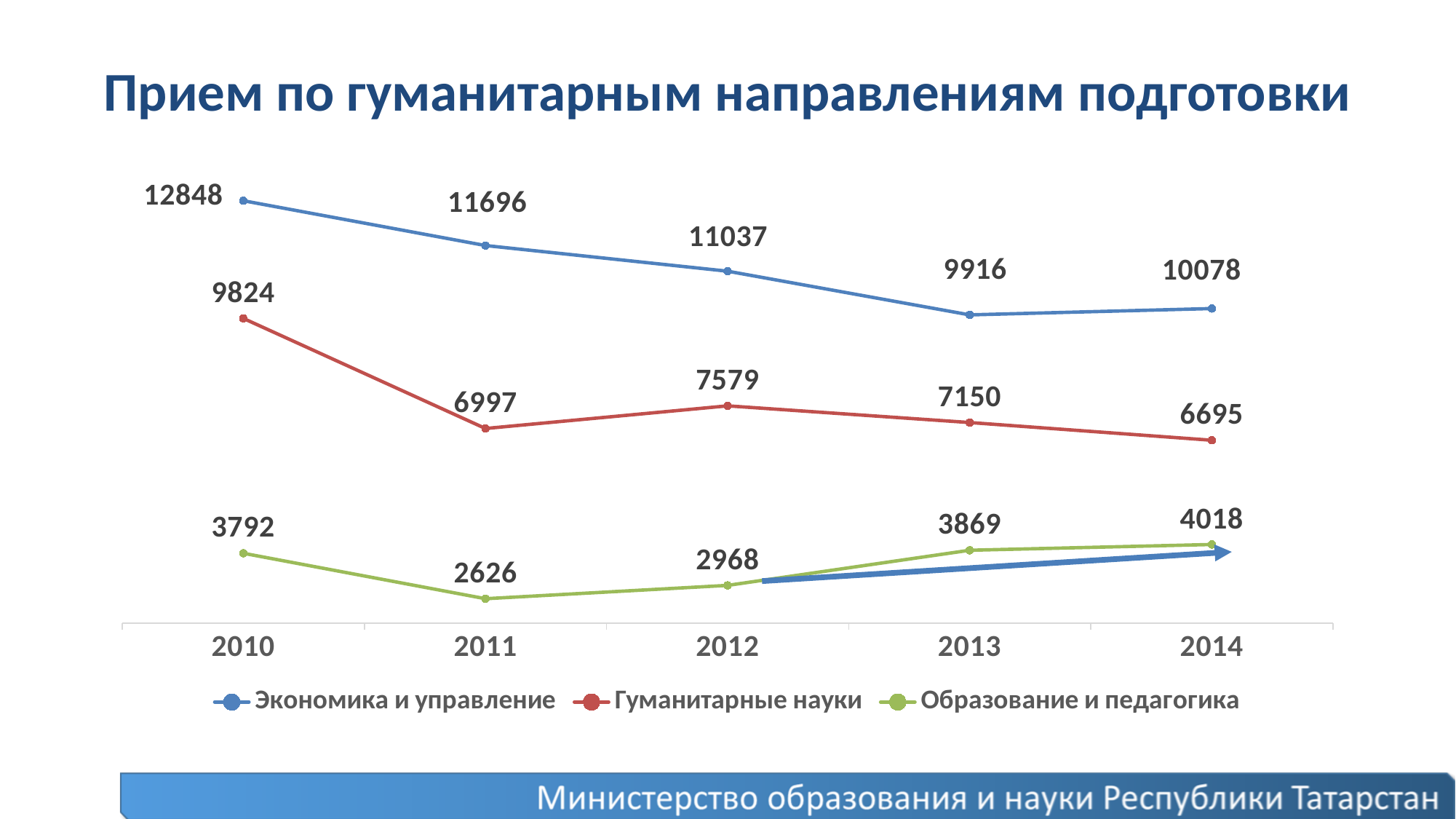
What is the difference between the Гуманитарные науки values in 2010 and 2011? 2827 What kind of chart is shown on the slide? line chart In which year is the value for Экономика и управление highest? 2010 In which year is the value for Образование и педагогика lowest? 2011 What is the difference between the Экономика и управление values in 2010 and 2014? 2770 What is the value for Экономика и управление in 2010? 12848 How many series does the legend list? 3 What is the value for Образование и педагогика in 2014? 4018 How many years are shown on the x axis? 5 Does the Экономика и управление series rise or fall from 2010 to 2013? fall What is the value for Гуманитарные науки in 2012? 7579 Which is larger: Гуманитарные науки in 2013 or Гуманитарные науки in 2014? 2013